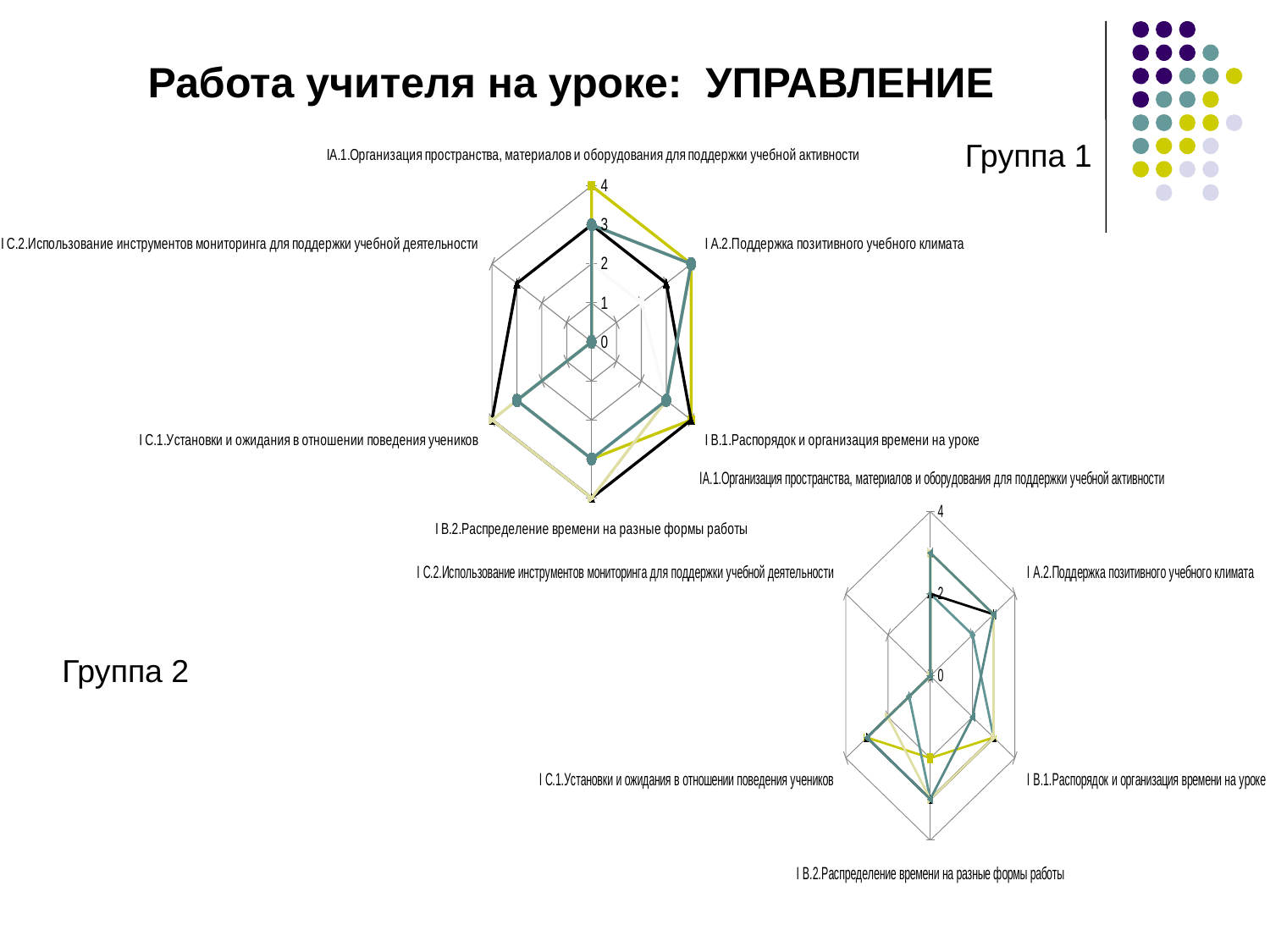
How many categories (axes) does the "Группа 1" radar chart have? 6 In the "Группа 1" chart, is the value of the black series for "I B.2.Распределение времени на разные формы работы" greater or less than 3? greater In the "Группа 1" chart, is the value of the teal series for "I C.2.Использование инструментов мониторинга для поддержки учебной деятельности" greater or less than 1? less In the "Группа 1" chart, is the value of the yellow series for "IA.1.Организация пространства, материалов и оборудования для поддержки учебной активности" greater or less than 2? greater In the "Группа 1" chart, what is the highest value shown on the radial axis? 4 What kind of chart is the "Группа 1" chart? radar chart What is the title of the slide containing the two radar charts? Работа учителя на уроке: УПРАВЛЕНИЕ How many categories (axes) does the "Группа 2" radar chart have? 6 What kind of chart is the "Группа 2" chart? radar chart